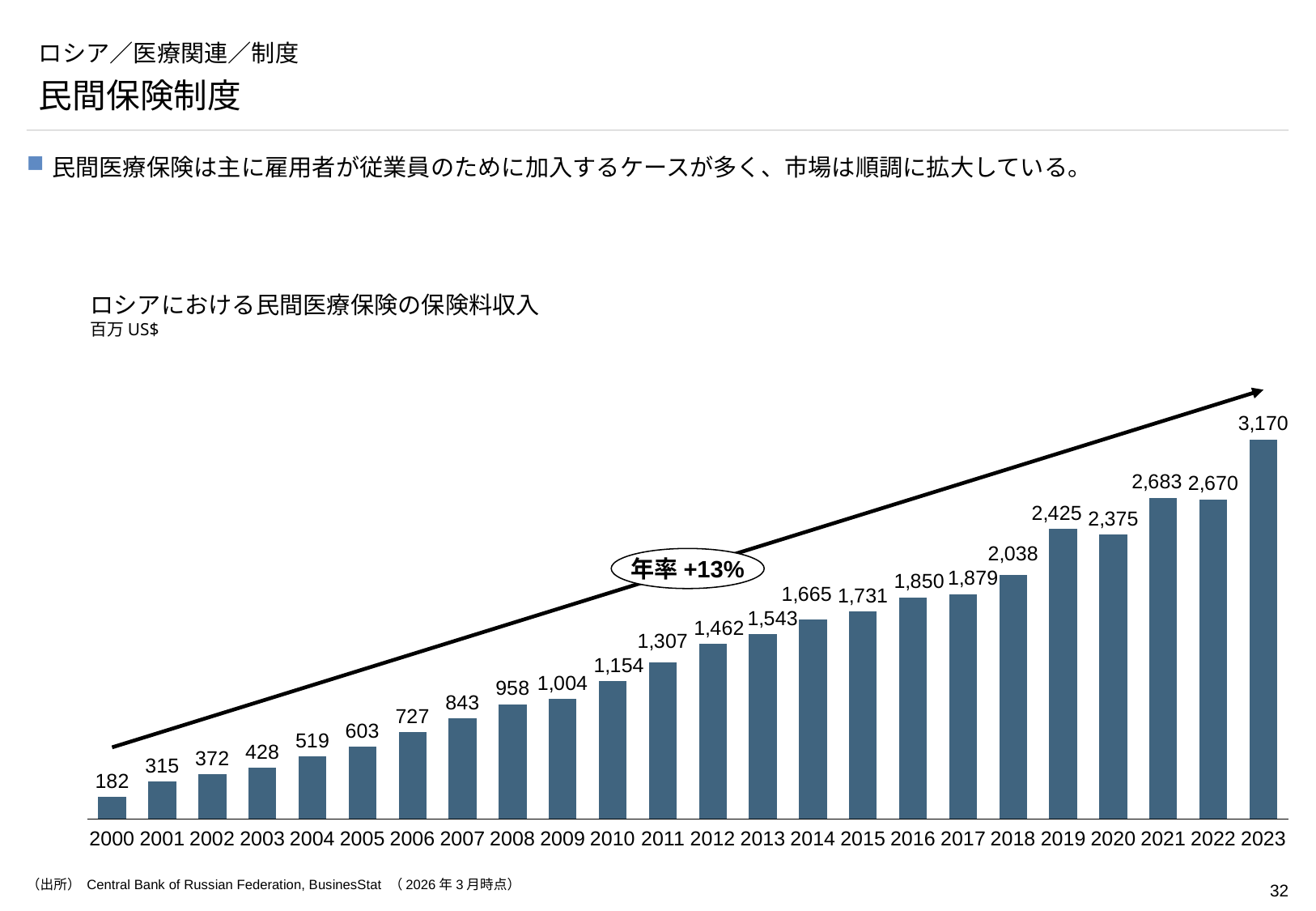
What is the value for 2012? 1,462 What is the value for 2023? 3,170 What kind of chart is this? Bar chart What unit is stated under the chart title? 百万 US$ Do the values generally rise or fall from 2000 to 2023? Rise Which year has the highest value? 2023 What is the value for 2000? 182 What is the difference between the values for 2023 and 2022? 500 How many years are shown on the x axis? 24 Which year has the lowest value? 2000 Which is larger, the value for 2019 or the value for 2020? 2019 What annual growth rate is written in the oval annotation on the chart? 年率 +13%